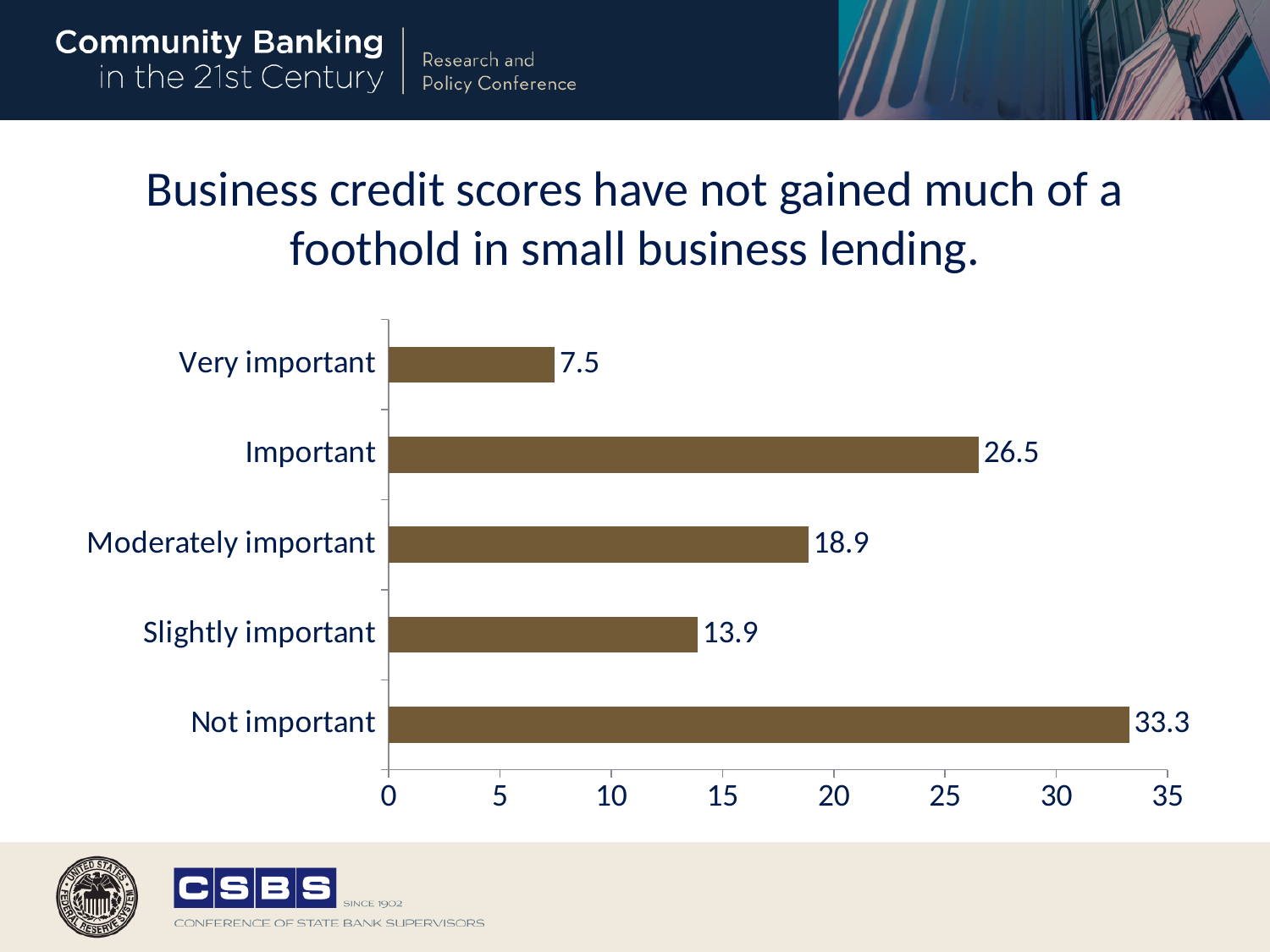
Which category has the highest value? Not important What kind of chart is shown on the slide? Bar chart What is the difference between the values for "Not important" and "Important"? 6.8 Which is larger, the value for "Important" or the value for "Moderately important"? Important What is the value for "Not important"? 33.3 What is the difference between the values for "Moderately important" and "Slightly important"? 5 How many categories are shown in the chart? 5 What is the value for "Moderately important"? 18.9 What is the value for "Very important"? 7.5 Which category has the lowest value? Very important Is the value for "Slightly important" greater or less than 15? less What is the maximum value shown on the horizontal axis? 35